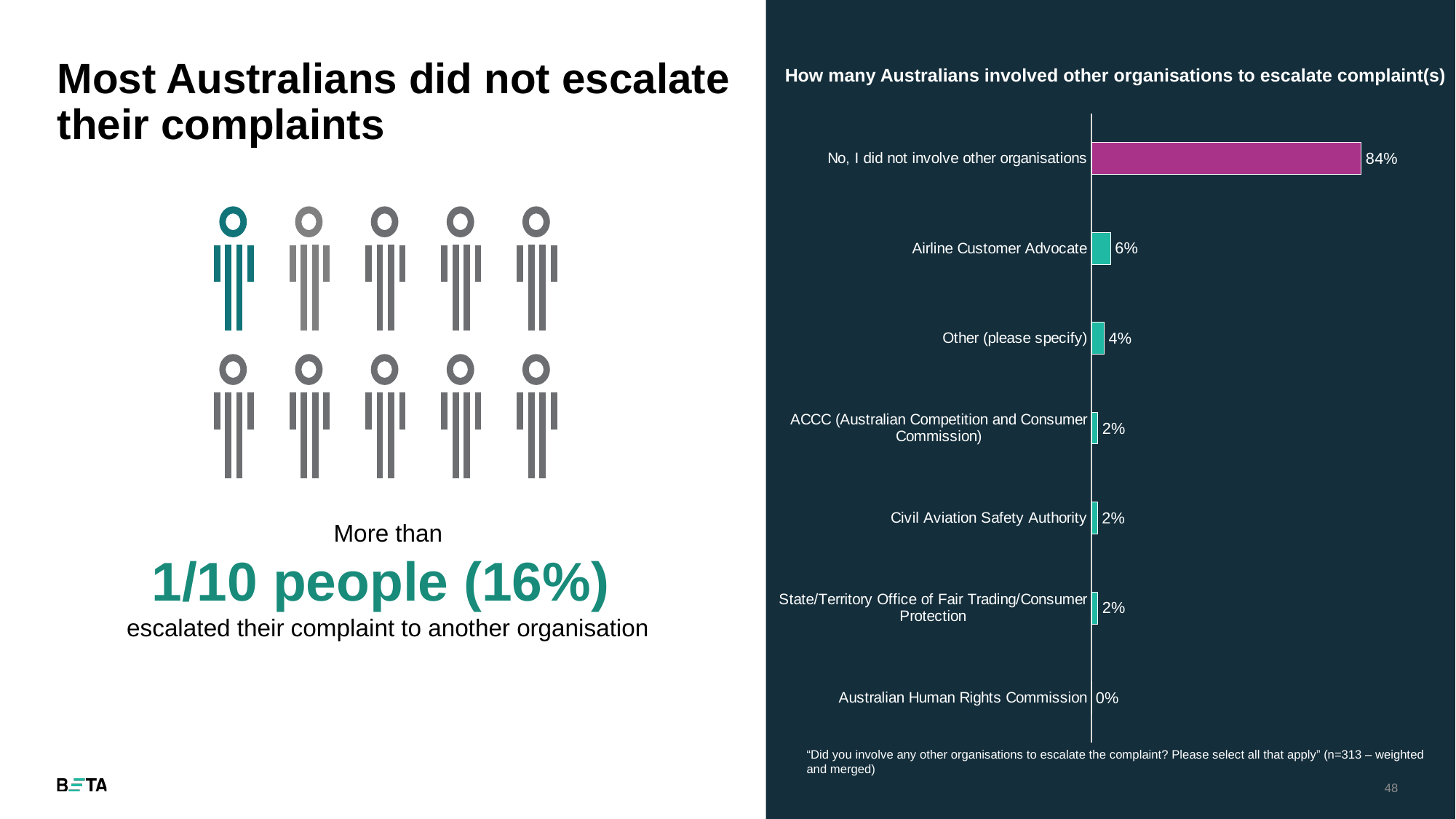
Which category has the highest value? No, I did not involve other organisations How many categories are shown in the chart? 7 Which is larger: 'Airline Customer Advocate' or 'Other (please specify)'? Airline Customer Advocate What is the difference between 'No, I did not involve other organisations' and 'Airline Customer Advocate'? 78% What is the value for 'Other (please specify)'? 4% What is the value for 'No, I did not involve other organisations'? 84% Which category has the lowest value? Australian Human Rights Commission What is the value for 'Airline Customer Advocate'? 6% What is the title of the chart? How many Australians involved other organisations to escalate complaint(s) What is the value for 'Australian Human Rights Commission'? 0% What kind of chart is shown on the slide? Bar chart What is the value for 'Civil Aviation Safety Authority'? 2%